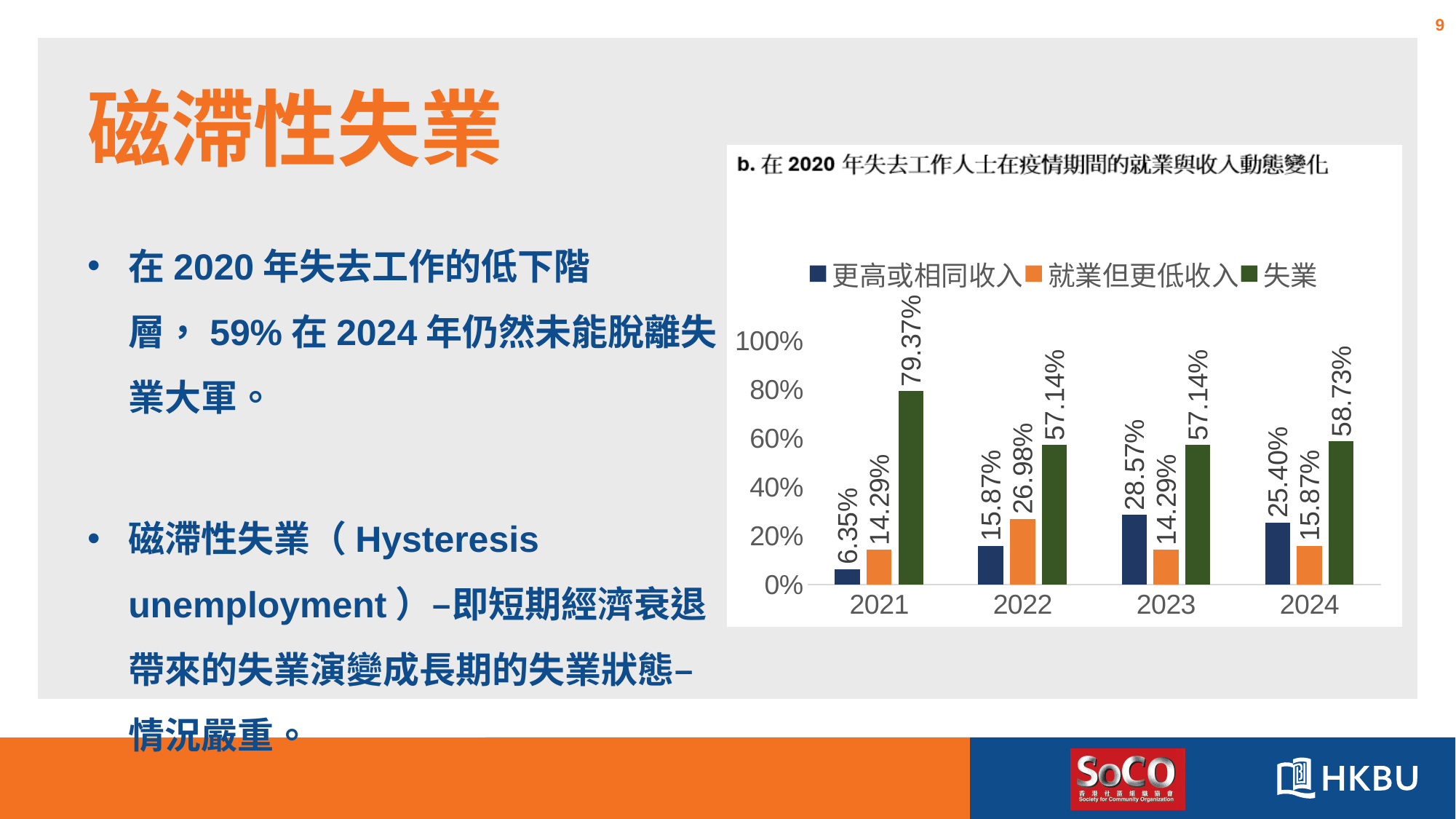
What is the value for 失業 in 2021? 79.37% In which year is the 更高或相同收入 value lowest? 2021 Which colour represents the 失業 series in the chart? Green How many years are shown on the x axis? 4 What is the value for 就業但更低收入 in 2022? 26.98% What is the difference between the 失業 values for 2021 and 2022? 22.23% In which year is the 失業 value highest? 2021 What kind of chart is shown on the slide? Bar chart Which is larger in 2023: 更高或相同收入 or 就業但更低收入? 更高或相同收入 How many series does the legend list? 3 What is the value for 失業 in 2024? 58.73% What is the value for 更高或相同收入 in 2023? 28.57%